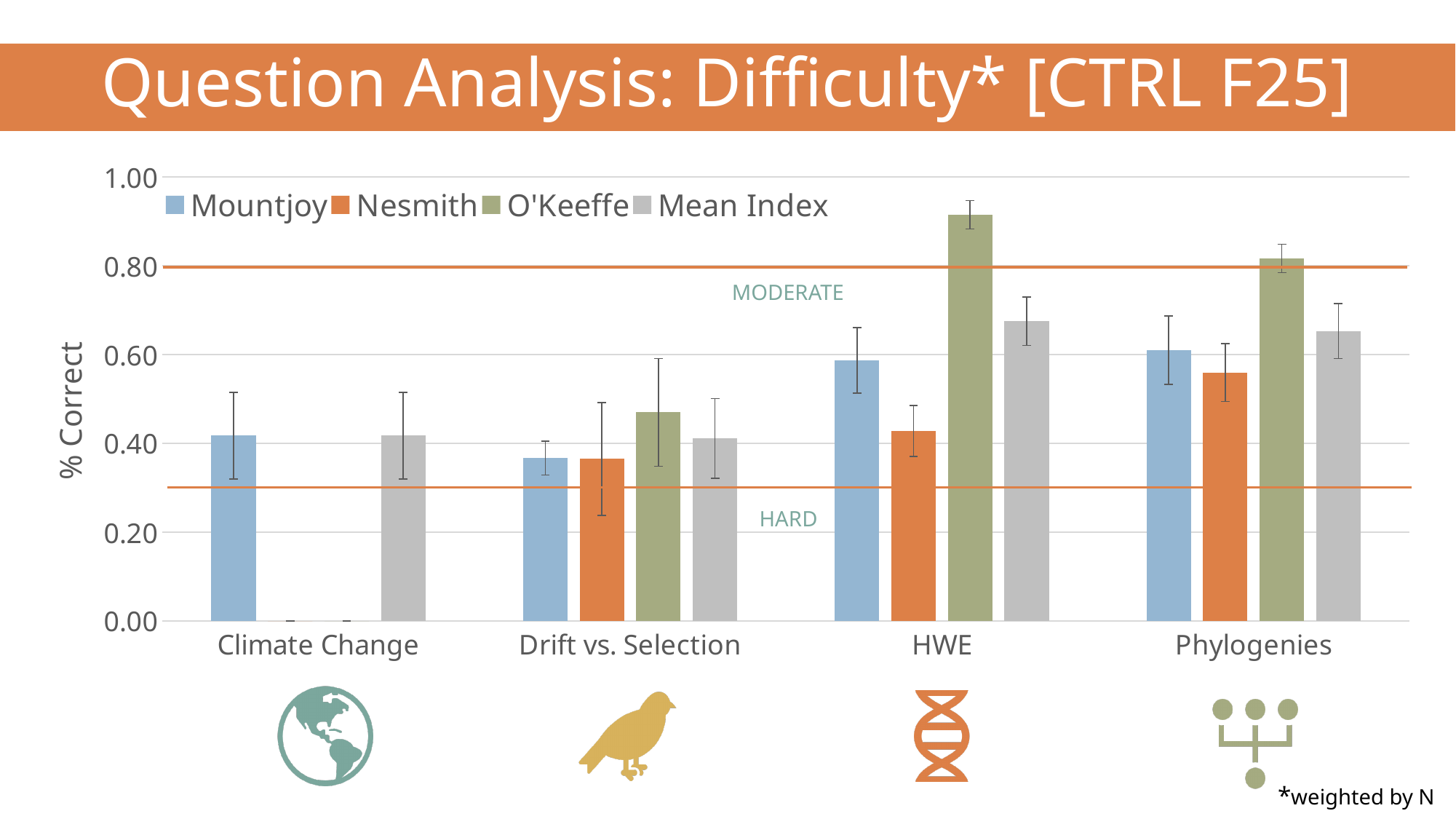
Is the Nesmith value for HWE greater or less than 0.60? less Is the Mountjoy value for Climate Change greater or less than 0.60? less For HWE, which is larger: the O'Keeffe value or the Mountjoy value? O'Keeffe How many series does the legend list? 4 What two labels are written next to the horizontal orange lines on the chart? MODERATE and HARD Is the O'Keeffe value for HWE greater or less than 0.80? greater For which category is the O'Keeffe bar the highest? HWE How many question categories are shown along the x axis? 4 For Phylogenies, which is larger: the O'Keeffe value or the Nesmith value? O'Keeffe What is the title of the y axis? % Correct What kind of chart is shown on the slide? bar chart For HWE, which series has the lowest value? Nesmith